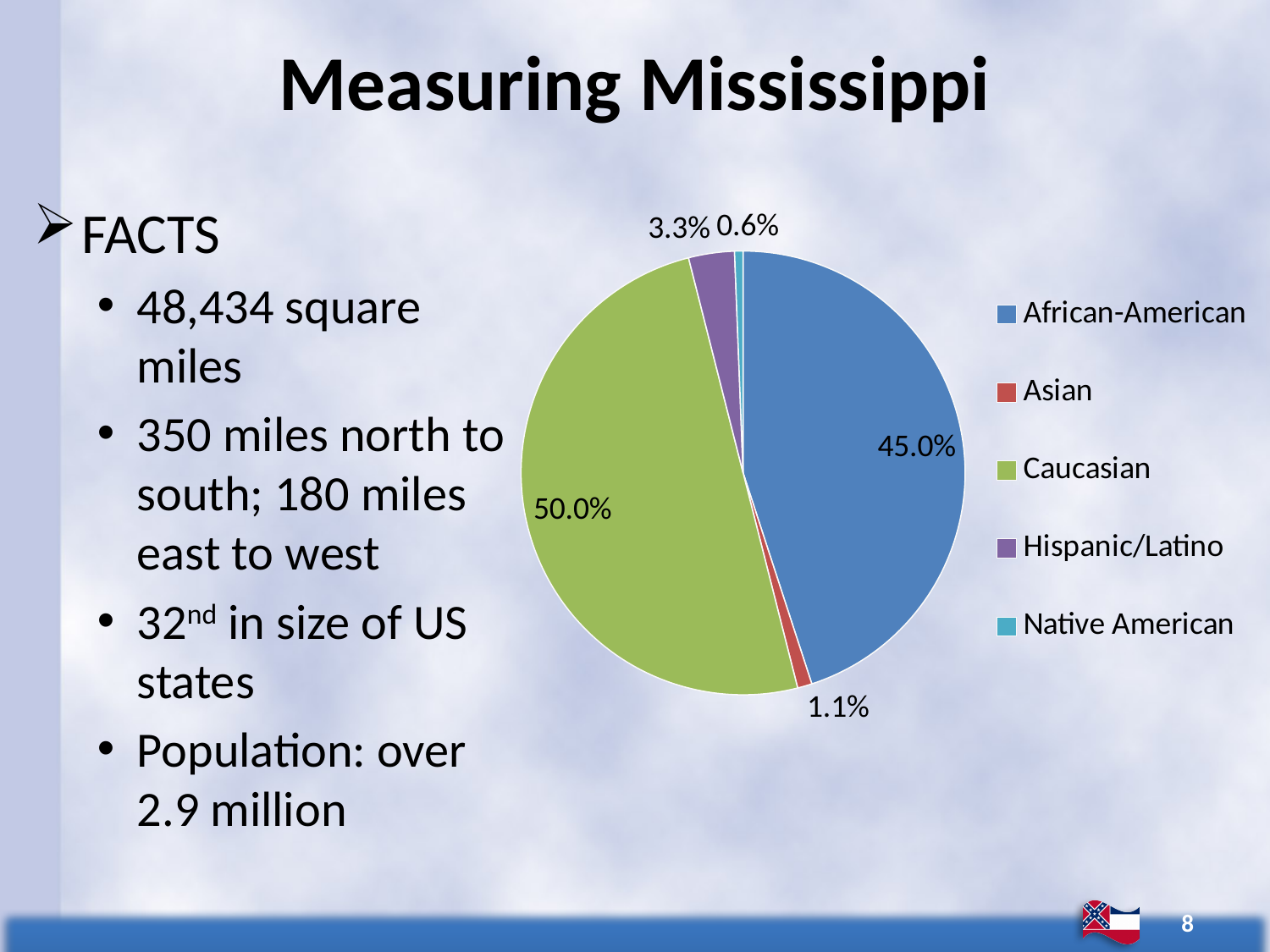
Which category has the largest slice of the pie? Caucasian How many categories does the legend list? 5 What share of the pie does the African-American slice represent? 45.0% Which category has the smallest slice of the pie? Native American What kind of chart is shown on the slide? pie chart What share of the pie does the Native American slice represent? 0.6% Which is larger, the Hispanic/Latino share or the Asian share? Hispanic/Latino What share of the pie does the Asian slice represent? 1.1% What share of the pie does the Caucasian slice represent? 50.0% What colour is the Caucasian slice in the pie chart? green What share of the pie does the Hispanic/Latino slice represent? 3.3% What is the difference between the Caucasian and African-American shares? 5.0%